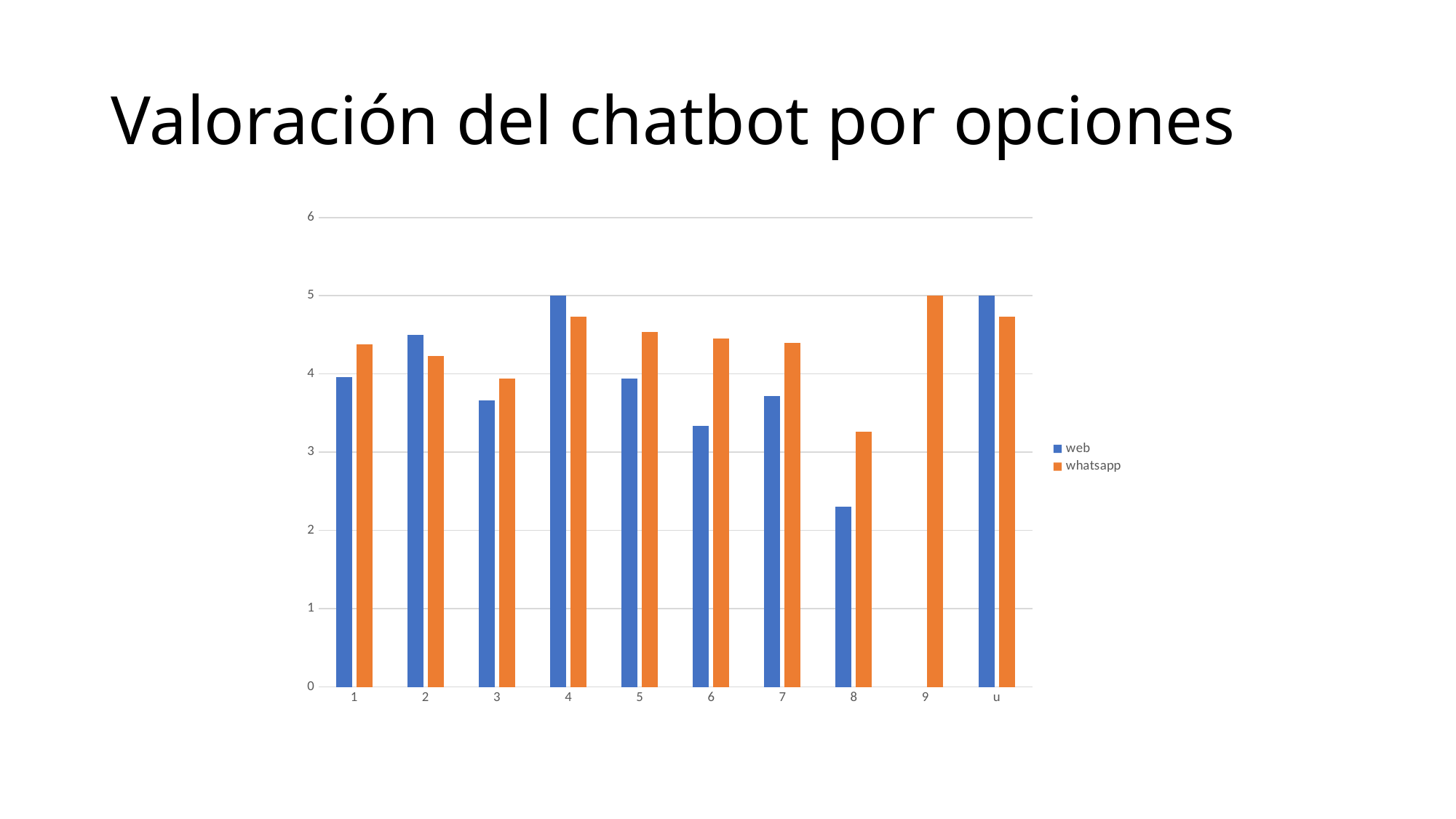
How many series does the legend list? 2 Which category has the highest whatsapp value? 9 What type of chart is shown on the slide? bar chart What is the title of the chart? Valoración del chatbot por opciones Is the value for whatsapp at category 5 greater or less than 4? greater How many categories are shown on the x axis? 10 At category 8, which series has the larger value, web or whatsapp? whatsapp At category 2, which series has the larger value, web or whatsapp? web Is the value for web at category 8 greater or less than 3? less Which category has the lowest web value? 8 What is the value for whatsapp at category 9? 5 What is the value for web at category 4? 5